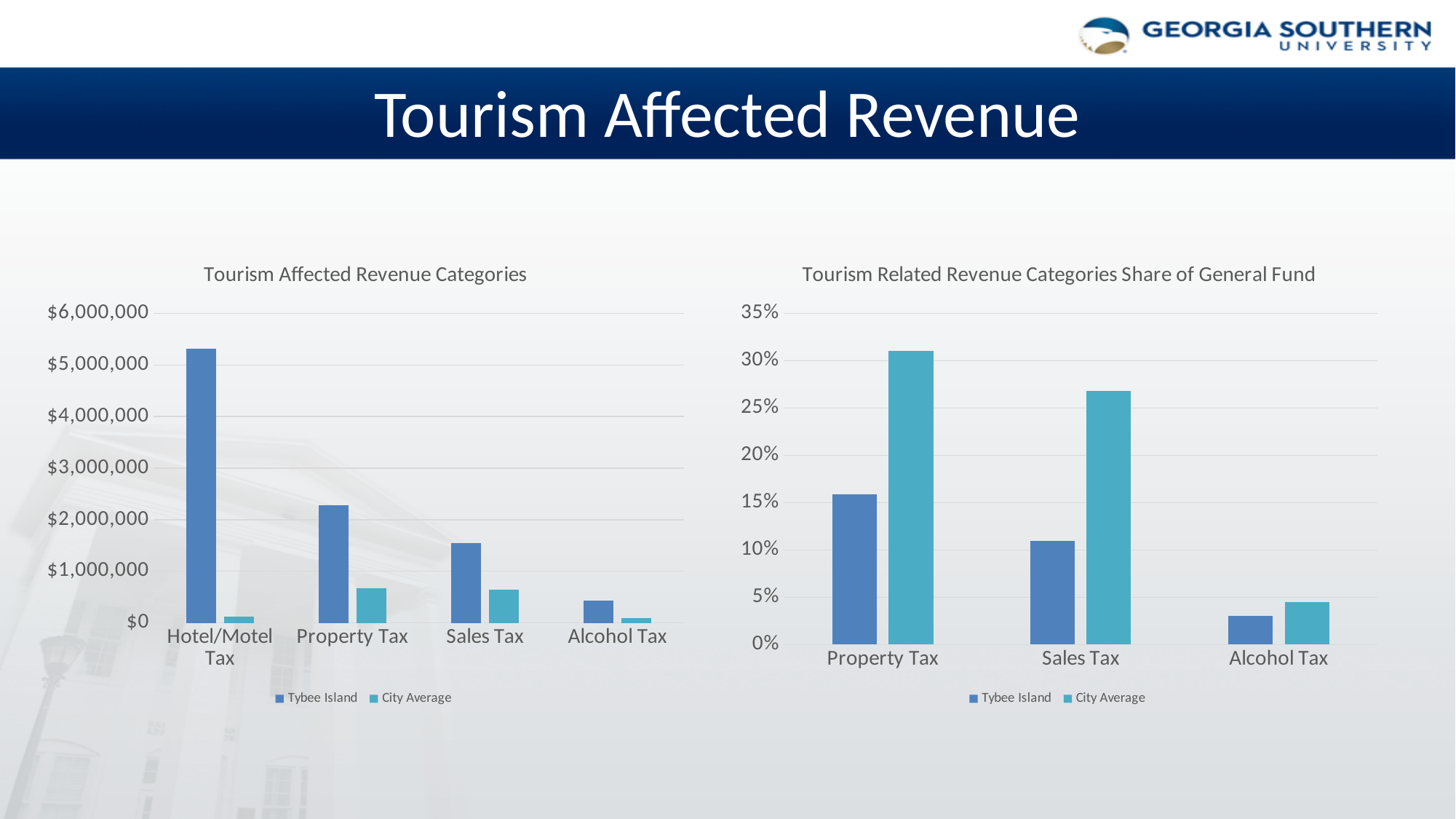
In the 'Tourism Affected Revenue Categories' chart, how many revenue categories are shown on the x axis? 4 In the 'Tourism Related Revenue Categories Share of General Fund' chart, which category has the highest City Average value? Property Tax In the 'Tourism Related Revenue Categories Share of General Fund' chart, how many categories are shown on the x axis? 3 In the 'Tourism Related Revenue Categories Share of General Fund' chart, is the City Average value for Sales Tax greater or less than 25%? greater In the 'Tourism Affected Revenue Categories' chart, which category has the highest Tybee Island value? Hotel/Motel Tax In the 'Tourism Affected Revenue Categories' chart, is the Tybee Island value for Hotel/Motel Tax greater or less than $5,000,000? greater In the 'Tourism Affected Revenue Categories' chart, how many series does the legend list? 2 What kind of chart is the 'Tourism Affected Revenue Categories' chart on the left? bar chart In the 'Tourism Related Revenue Categories Share of General Fund' chart, which category has the lowest Tybee Island value? Alcohol Tax In the 'Tourism Related Revenue Categories Share of General Fund' chart, which is larger for Property Tax: Tybee Island or City Average? City Average In the 'Tourism Affected Revenue Categories' chart, do the Tybee Island values rise or fall from Hotel/Motel Tax to Alcohol Tax? fall In the 'Tourism Affected Revenue Categories' chart, which is larger for Property Tax: Tybee Island or City Average? Tybee Island